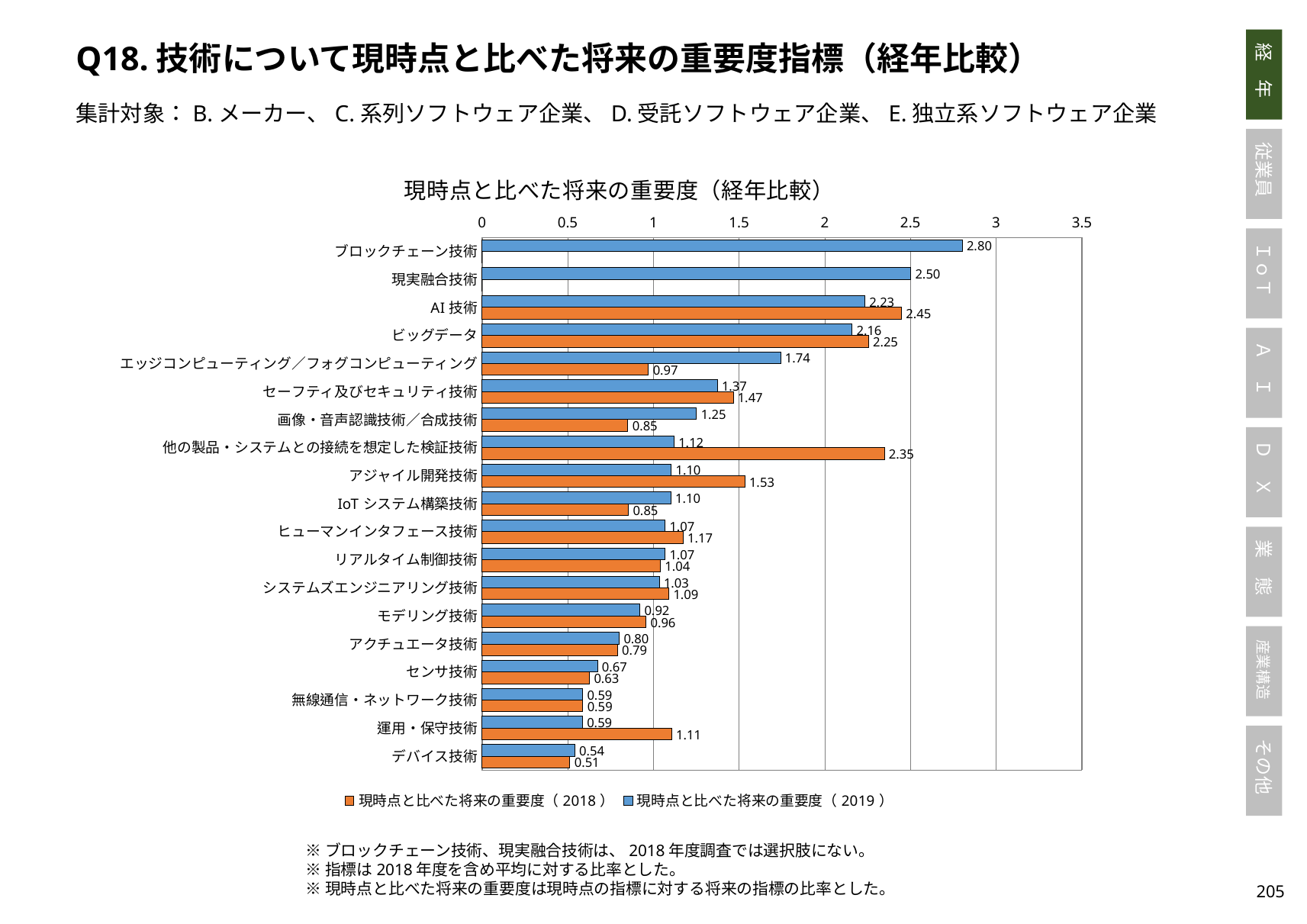
For AI 技術, which is larger, the 2018 value or the 2019 value? 2018 How many technology categories are plotted on the chart? 19 What is the 2019 value for ブロックチェーン技術? 2.80 What is the 2018 value for 運用・保守技術? 1.11 Which category has the lowest 2019 value? デバイス技術 How many series does the legend list? 2 What type of chart is shown on the slide? Bar chart Which colour represents the 2019 series in the chart? Blue What is the 2018 value for 他の製品・システムとの接続を想定した検証技術? 2.35 Which category has the highest 2019 value? ブロックチェーン技術 Which category has the highest 2018 value? AI 技術 What is the difference between the 2019 and 2018 values for エッジコンピューティング／フォグコンピューティング? 0.77